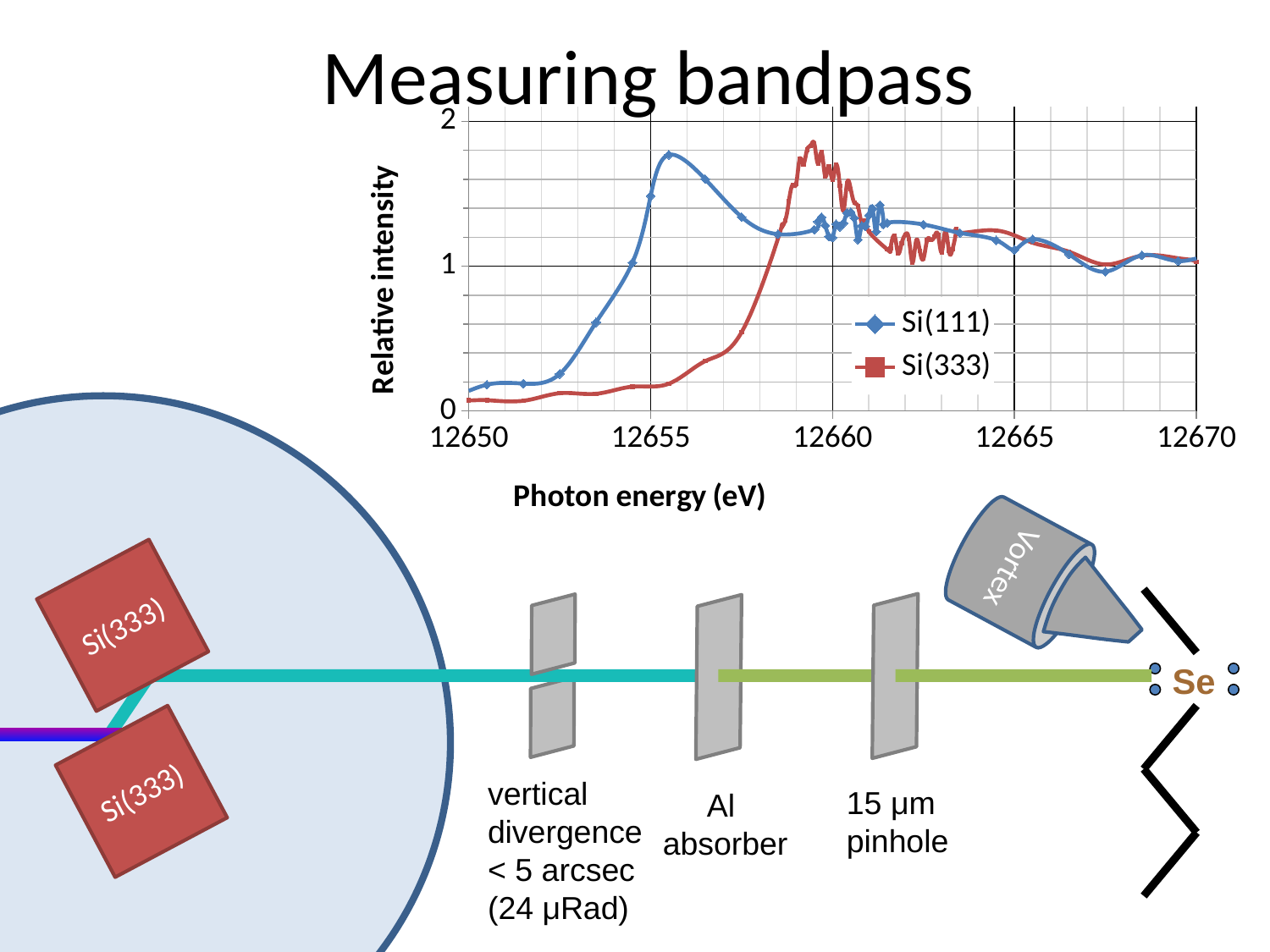
How many series does the chart legend list? 2 At 12655 eV, which series has the larger relative intensity, Si(111) or Si(333)? Si(111) Is the value of the Si(111) series at 12650 eV greater or less than 1? less What is the label of the chart's x axis? Photon energy (eV) Does the Si(333) series rise or fall between 12657 eV and 12659 eV? rise What are the two series named in the chart legend? Si(111) and Si(333) Is the peak value of the Si(111) series greater or less than 1? greater Around 12659.5 eV, which series has the larger relative intensity, Si(111) or Si(333)? Si(333) Is the peak value of the Si(333) series greater or less than 1? greater Does the Si(111) series rise or fall between 12650 eV and 12655 eV? rise What kind of chart is shown on the slide? line chart